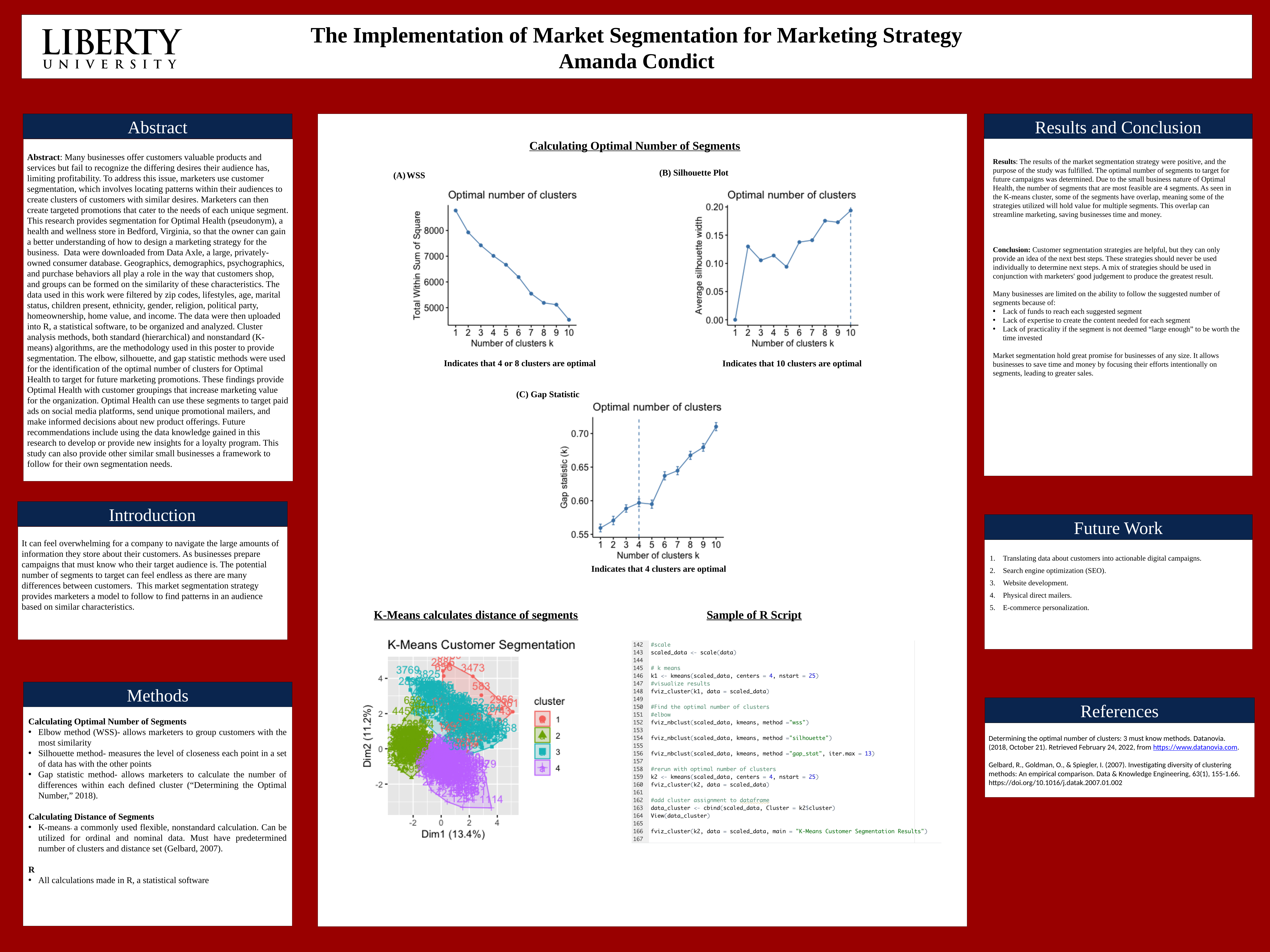
In the (A) WSS chart, is the value at k = 1 greater or less than 8000? greater In the (C) Gap Statistic chart, is the gap statistic at k = 2 larger or smaller than at k = 9? smaller In the (B) Silhouette Plot, what is the average silhouette width at k = 1? 0.00 In the K-Means Customer Segmentation chart, how many clusters does the legend list? 4 In the (A) WSS chart, do the values rise or fall as the number of clusters k increases? fall In the (B) Silhouette Plot, which number of clusters k has the highest average silhouette width? 10 In the (C) Gap Statistic chart, is the gap statistic at k = 10 greater or less than 0.70? greater In the (C) Gap Statistic chart, which number of clusters k has the lowest gap statistic? 1 In the (A) WSS chart, is the value at k = 10 greater or less than 5000? less In the (A) WSS chart, what kind of chart is used to show the total within sum of square against the number of clusters? line chart In the (A) WSS chart, how many cluster values (points) are plotted along the x axis? 10 In the (B) Silhouette Plot, at which number of clusters k is the dashed vertical line drawn? 10